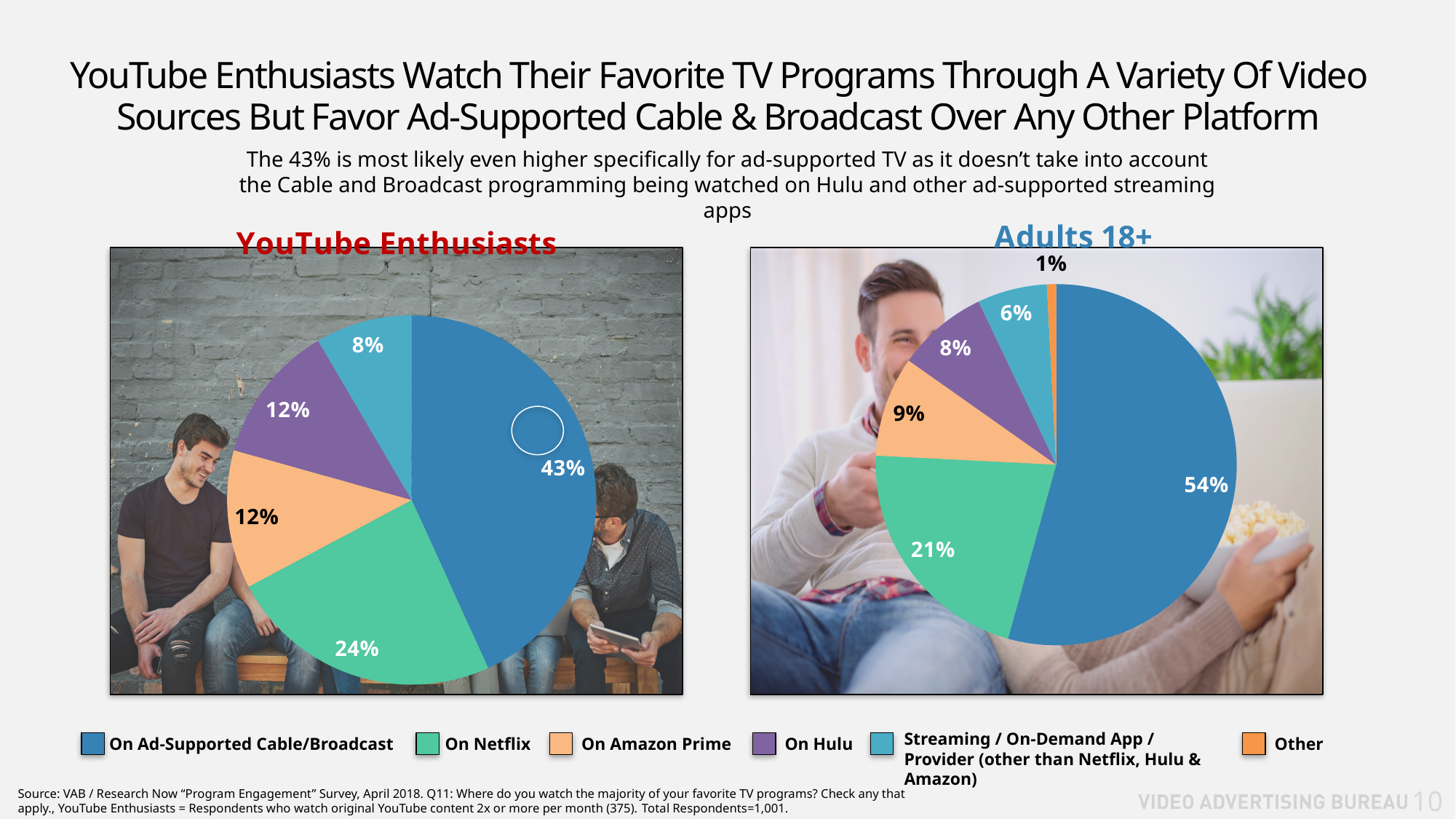
In the Adults 18+ pie chart, which category has the largest slice? On Ad-Supported Cable/Broadcast In the YouTube Enthusiasts pie chart, what share is Streaming / On-Demand App / Provider (other than Netflix, Hulu & Amazon)? 8% How many slices does the Adults 18+ pie chart have? 6 What is the difference between the On Ad-Supported Cable/Broadcast share in the Adults 18+ chart and in the YouTube Enthusiasts chart? 11 percentage points In the YouTube Enthusiasts pie chart, what share is On Ad-Supported Cable/Broadcast? 43% In the Adults 18+ pie chart, what share is On Amazon Prime? 9% In the Adults 18+ pie chart, what share is On Netflix? 21% In the YouTube Enthusiasts pie chart, which category has the largest slice? On Ad-Supported Cable/Broadcast What type of chart is used for the YouTube Enthusiasts data? Pie chart Which is larger: the On Netflix share for YouTube Enthusiasts or for Adults 18+? YouTube Enthusiasts In the Adults 18+ pie chart, which category has the smallest slice? Other How many categories does the legend list? 6